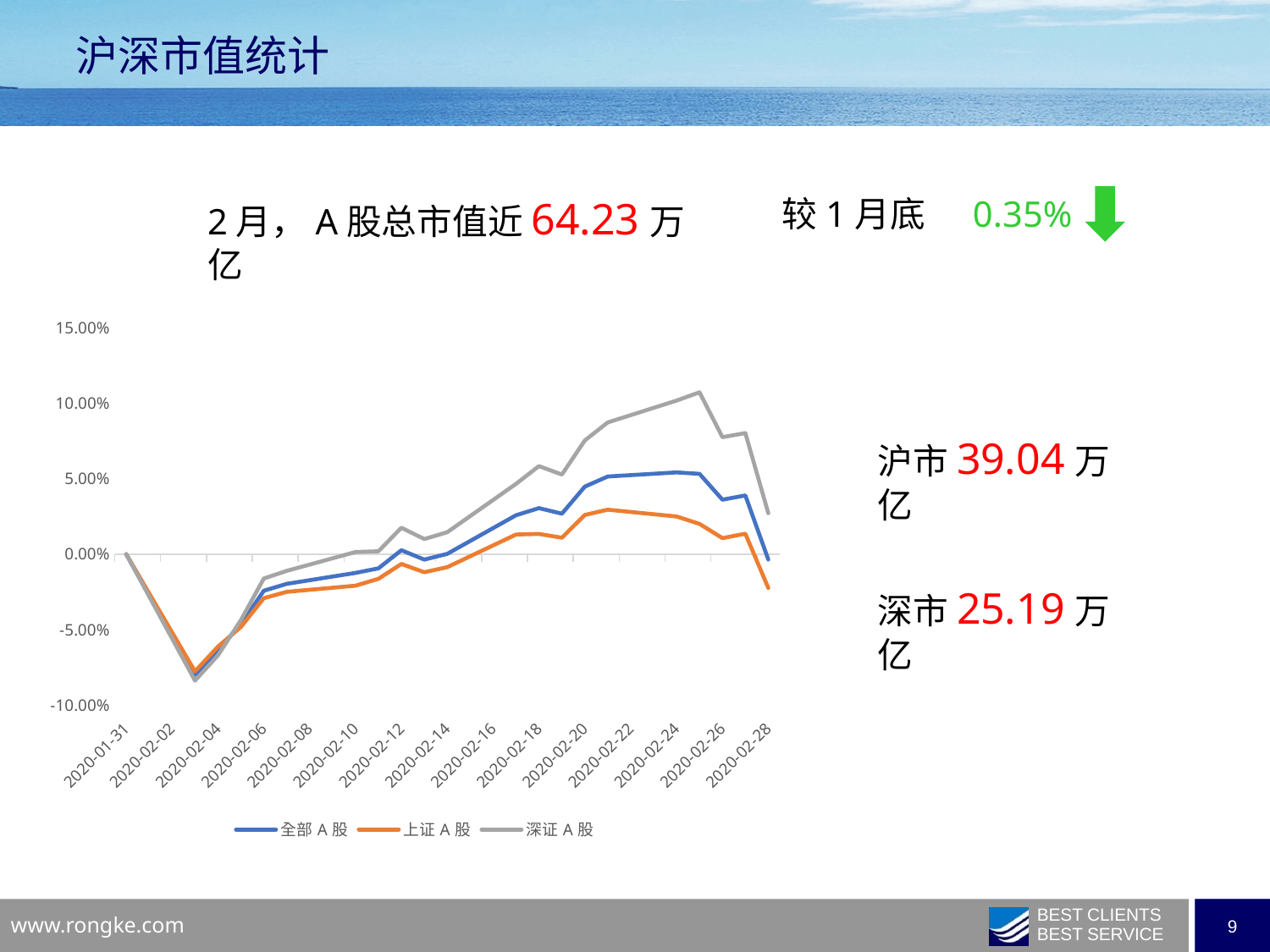
Between 2020-02-04 and 2020-02-24, does the 全部A股 line generally rise or fall? rise At 2020-02-20, which is larger: the value for 全部A股 or the value for 上证A股? 全部A股 How many series does the chart legend list? 3 Is the value for 上证A股 at 2020-02-28 greater or less than 0.00%? less Which series has the lowest value at 2020-02-28? 上证A股 Is the value for 深证A股 at 2020-02-22 greater or less than 5.00%? greater Which series has the highest value around 2020-02-24? 深证A股 Which series is plotted with the gray line? 深证A股 How many date labels are shown on the x axis? 15 What are the three series named in the chart legend? 全部A股, 上证A股, 深证A股 Is the lowest point of the 全部A股 line (around 2020-02-03) greater or less than -5.00%? less What kind of chart is shown on the slide? line chart